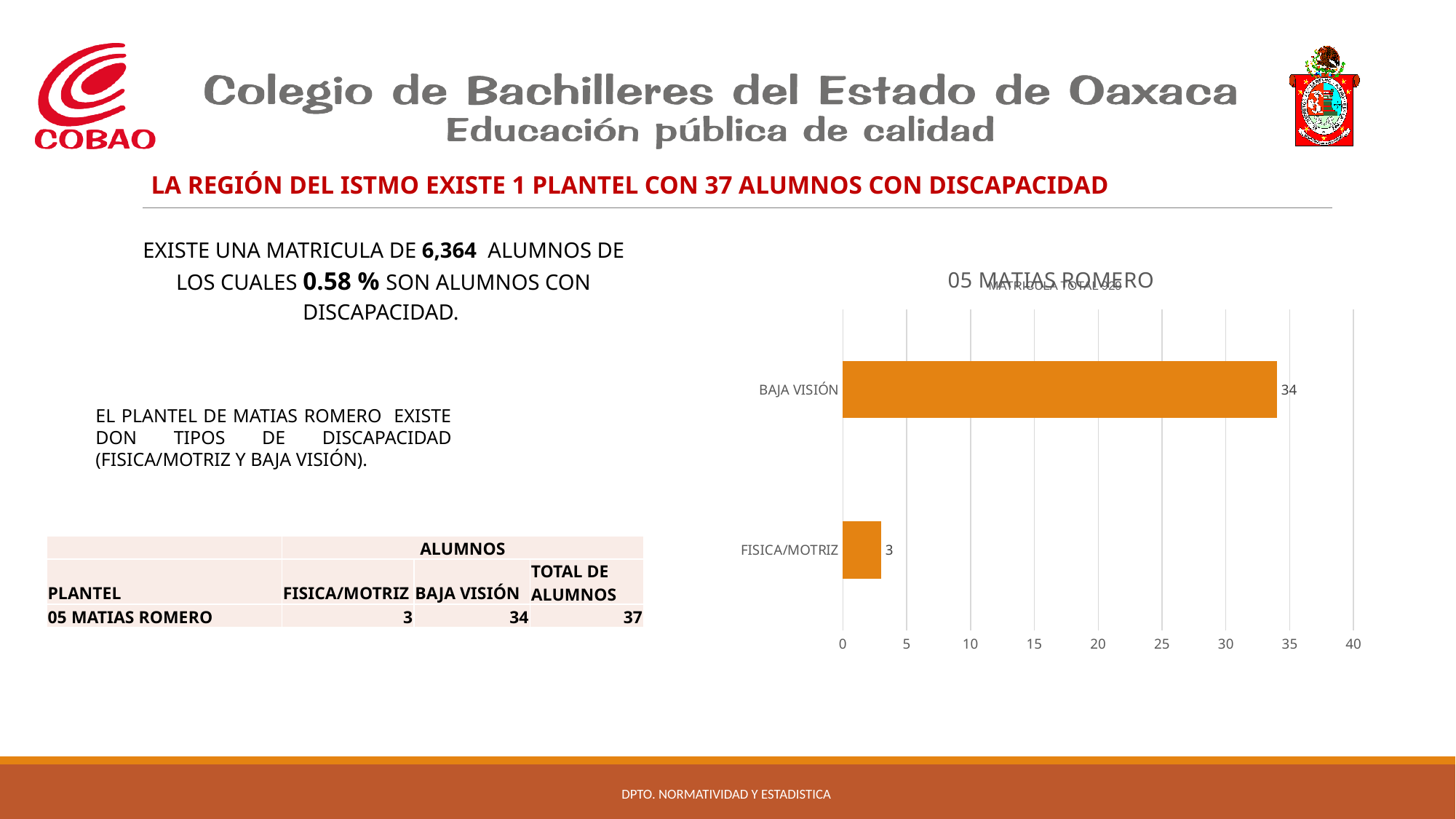
What is the maximum value shown on the chart's horizontal axis? 40 Which is larger, the value for BAJA VISIÓN or the value for FISICA/MOTRIZ? BAJA VISIÓN Which category has the lowest value in the chart? FISICA/MOTRIZ What kind of chart is shown on the slide? bar chart What is the value for BAJA VISIÓN in the chart? 34 Is the value for FISICA/MOTRIZ greater or less than 5? less What is the title of the chart? 05 MATIAS ROMERO How many categories are shown in the chart? 2 What is the value for FISICA/MOTRIZ in the chart? 3 Is the value for BAJA VISIÓN greater or less than 30? greater Which category has the highest value in the chart? BAJA VISIÓN What is the difference between the values for BAJA VISIÓN and FISICA/MOTRIZ? 31